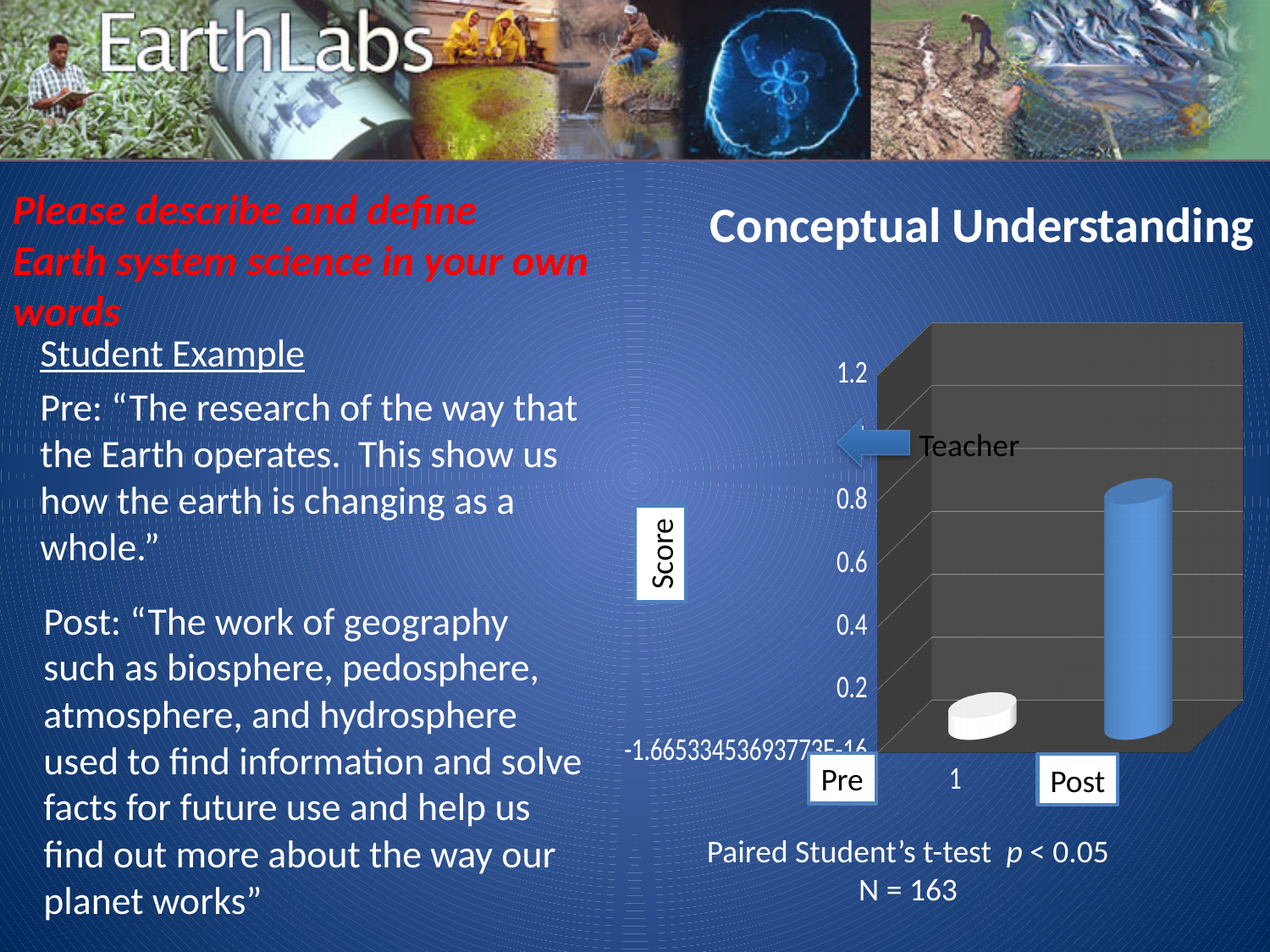
Does the score rise or fall from Pre to Post? rise Is the score for Post larger or smaller than the score for Pre? larger What kind of chart is shown on the slide? bar chart Is the value for Post greater or less than 0.6? greater What is the title of the chart? Conceptual Understanding Is the value for Pre greater or less than 0.2? less Is the value for Pre greater or less than 0.4? less What is the label on the vertical axis of the chart? Score Which category has the highest score, Pre or Post? Post Which category has the lowest score in the chart? Pre How many bars are plotted in the chart? 2